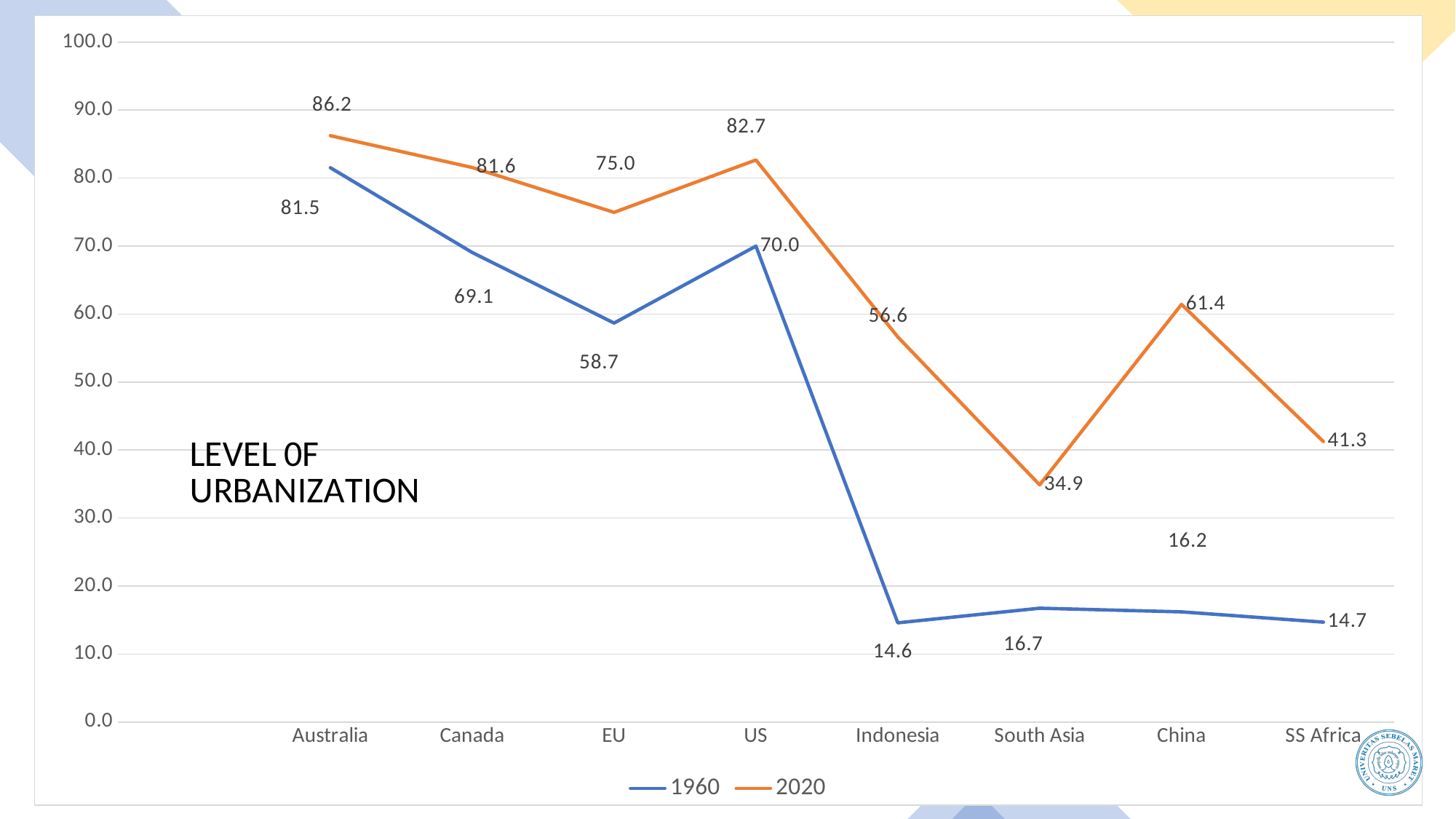
Which category has the lowest 1960 value? Indonesia What is the difference between the 2020 and 1960 values for China? 45.2 Is the 1960 value for US greater or less than 60.0? greater Does the 1960 series rise or fall from Australia to EU? fall How many series does the legend list? 2 What type of chart is shown on the slide? line chart What is the 1960 value for EU? 58.7 Which series is drawn in orange? 2020 How many categories are shown on the x axis? 8 Which category has the highest 2020 value? Australia What is the 2020 value for Indonesia? 56.6 Which is larger, the 2020 value for South Asia or the 2020 value for SS Africa? SS Africa